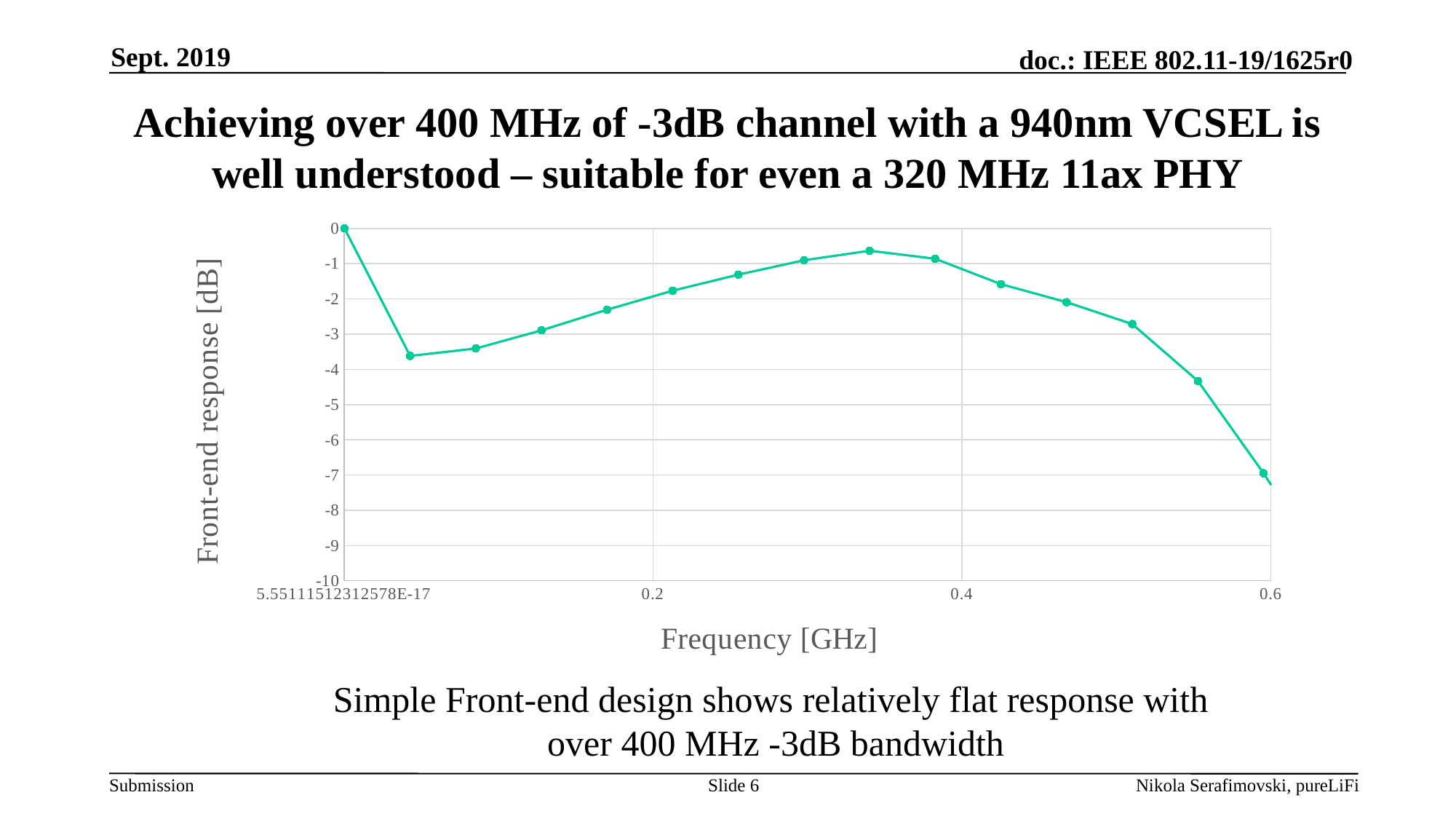
Does the front-end response rise or fall as frequency increases from 0.4 GHz to 0.6 GHz? fall What is the label of the vertical axis of the chart? Front-end response [dB] What is the label of the horizontal axis of the chart? Frequency [GHz] Is the front-end response at the second data point (just after 0 GHz) greater or less than -3 dB? less What kind of chart is shown on the slide? line chart Is the front-end response at the data point just above 0.2 GHz greater or less than -3 dB? greater At which end of the frequency axis does the chart show its lowest front-end response? near 0.6 GHz Is the front-end response at the last data point near 0.6 GHz greater or less than -5 dB? less How many data points are plotted on the line chart? 15 At which frequency does the chart show its highest front-end response? the first point (0 GHz) Which is larger, the front-end response at the data point near 0.34 GHz or at the data point near 0.6 GHz? near 0.34 GHz What is the front-end response value at the first data point (lowest frequency) on the chart? 0